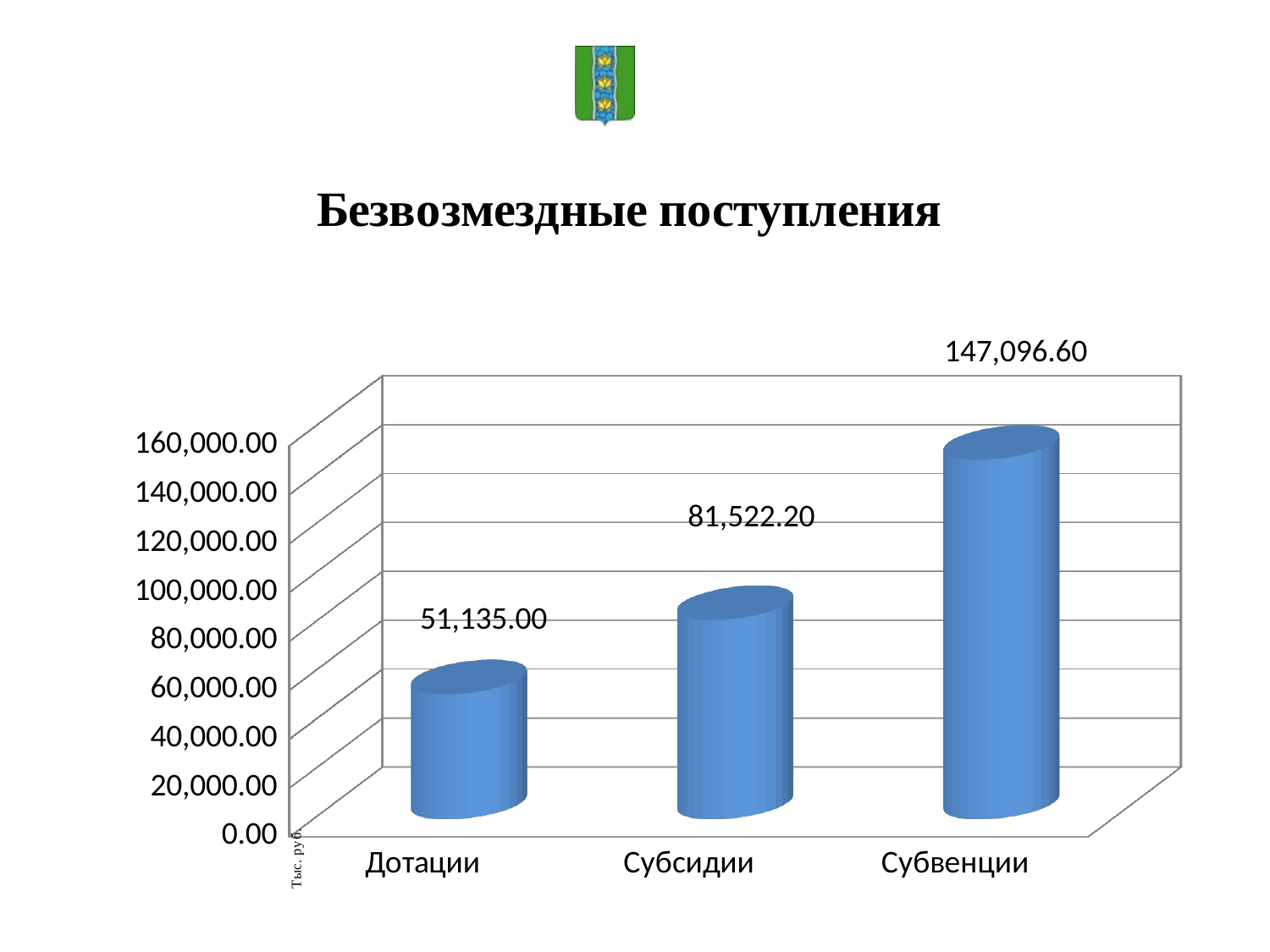
What is the difference between the values for Субвенции and Дотации? 95,961.60 How many categories are shown on the x axis? 3 What is the title of the chart? Безвозмездные поступления Which category has the highest value? Субвенции Which is larger, the value for Субсидии or the value for Субвенции? Субвенции Is the value for Субсидии greater or less than 100,000.00? less What is the value for Субвенции? 147,096.60 Which category has the lowest value? Дотации What is the value for Субсидии? 81,522.20 What is the difference between the values for Субсидии and Дотации? 30,387.20 What is the value for Дотации? 51,135.00 What kind of chart is shown on the slide? bar chart